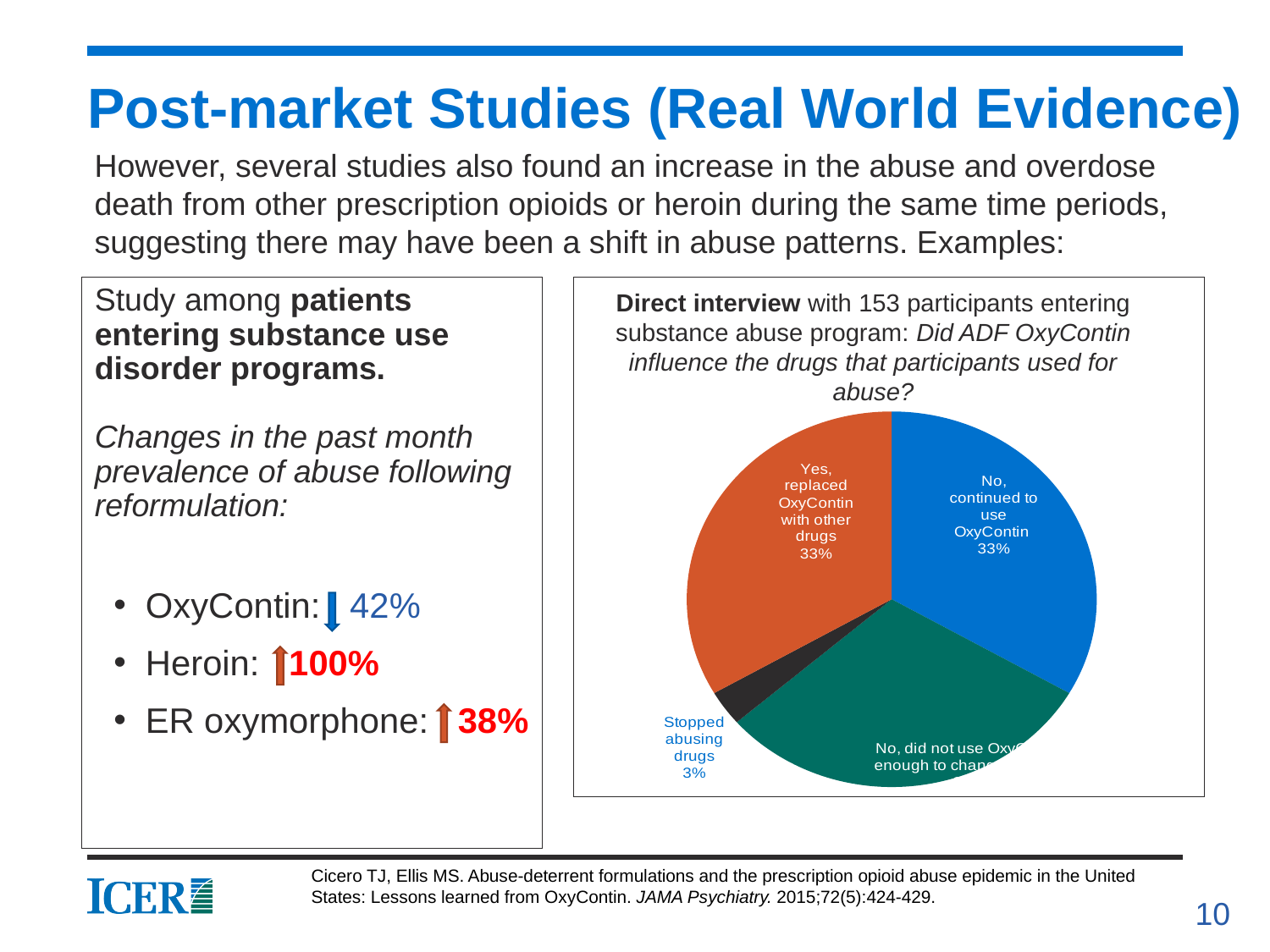
In the pie chart, what percentage of participants said "Yes, replaced OxyContin with other drugs"? 33% What share of the pie does the "Stopped abusing drugs" slice represent? 3% How many participants were included in the direct interview shown in the pie chart? 153 In the pie chart, what is the difference in percentage points between "No, continued to use OxyContin" and "Stopped abusing drugs"? 30 percentage points What colour is the "No, continued to use OxyContin" slice in the pie chart? Blue What kind of chart is shown on the slide? Pie chart In the pie chart, what percentage of participants said "No, continued to use OxyContin"? 33% In the pie chart, which is larger: the share for "Yes, replaced OxyContin with other drugs" or the share for "Stopped abusing drugs"? Yes, replaced OxyContin with other drugs In the pie chart, what percentage of participants said they "Stopped abusing drugs"? 3% Which slice of the pie chart is the smallest? Stopped abusing drugs How many slices does the pie chart have? 4